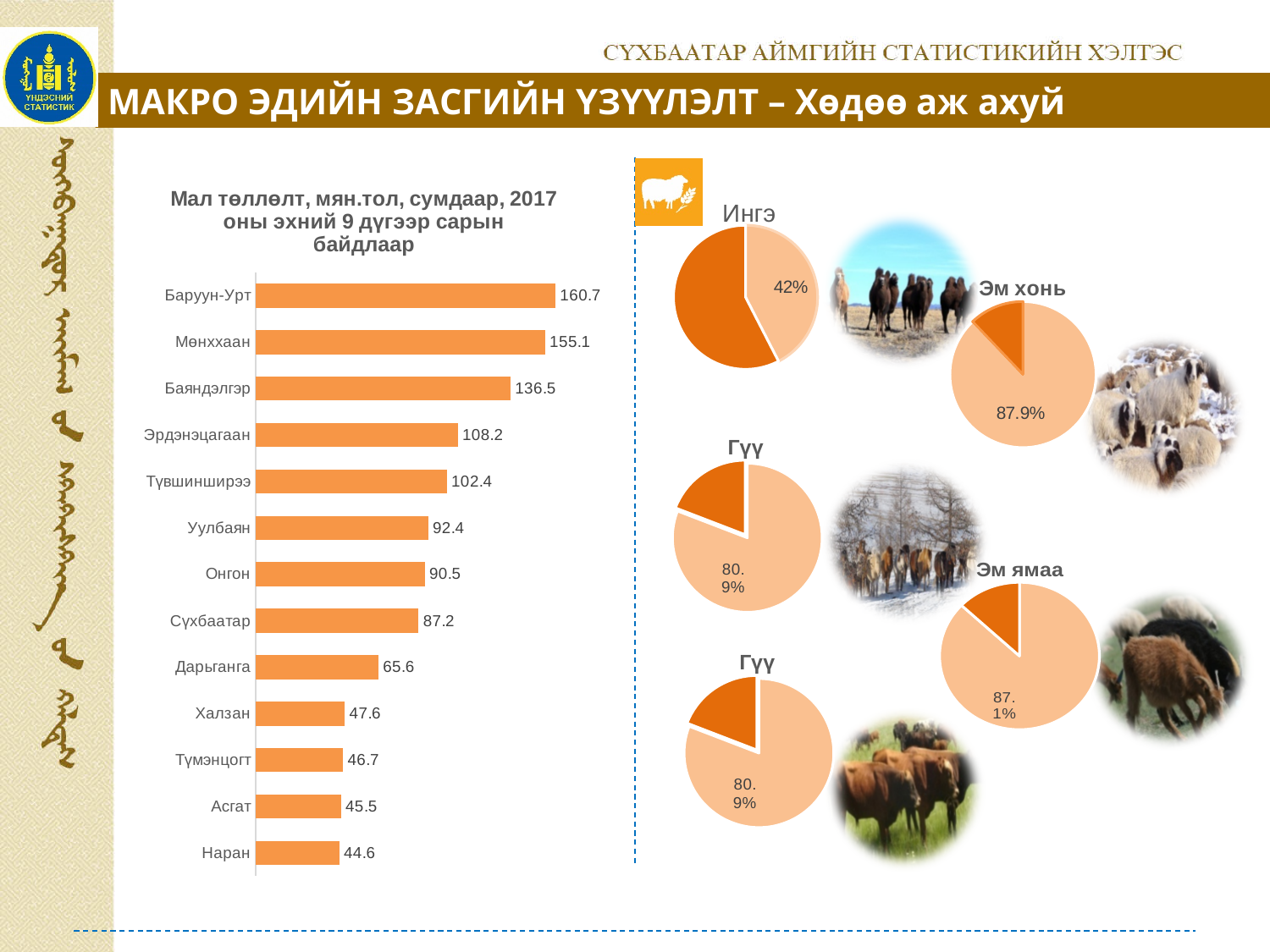
In the bar chart 'Мал төллөлт, мян.тол, сумдаар, 2017 оны эхний 9 дүгээр сарын байдлаар', what is the value for Баруун-Урт? 160.7 In the pie chart titled 'Эм ямаа', what percentage is shown for the labelled slice? 87.1% In the bar chart 'Мал төллөлт, мян.тол, сумдаар', which category has the highest value? Баруун-Урт In the bar chart 'Мал төллөлт, мян.тол, сумдаар', what is the value for Сүхбаатар? 87.2 In the pie chart titled 'Ингэ', what percentage is shown for the labelled slice? 42% In the bar chart 'Мал төллөлт, мян.тол, сумдаар', which category has the lowest value? Наран In the bar chart 'Мал төллөлт, мян.тол, сумдаар', what is the value for Дарьганга? 65.6 In the bar chart 'Мал төллөлт, мян.тол, сумдаар', what is the difference between the values for Баруун-Урт and Мөнххаан? 5.6 In the pie chart titled 'Эм хонь', what percentage is shown for the labelled slice? 87.9% How many categories are shown in the bar chart 'Мал төллөлт, мян.тол, сумдаар'? 13 What kind of chart is 'Мал төллөлт, мян.тол, сумдаар, 2017 оны эхний 9 дүгээр сарын байдлаар'? bar chart In the bar chart 'Мал төллөлт, мян.тол, сумдаар', which is larger, the value for Уулбаян or the value for Онгон? Уулбаян